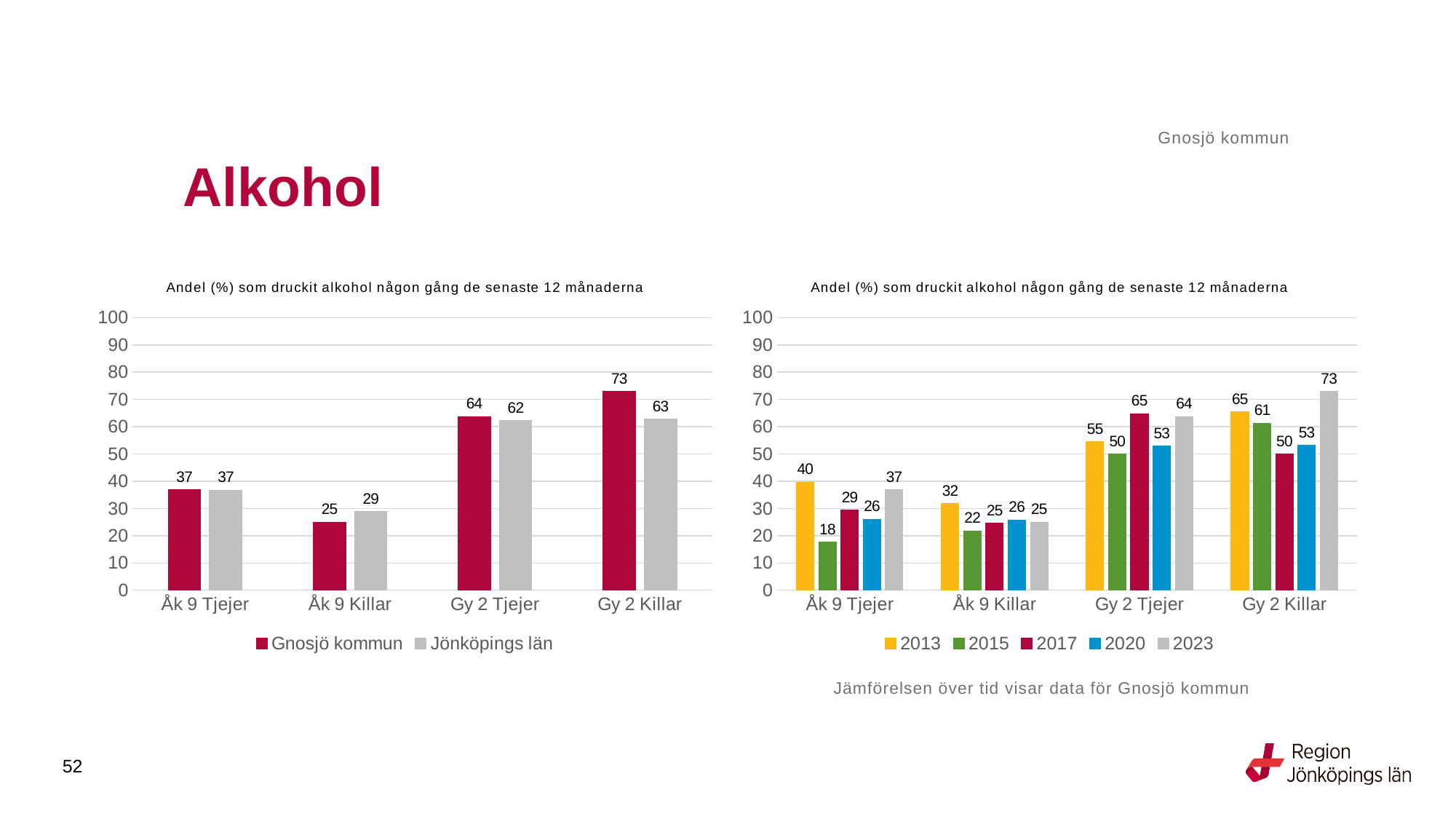
In the left chart, what is the value for Gnosjö kommun for Gy 2 Killar? 73 In the left chart, what is the value for Jönköpings län for Åk 9 Killar? 29 In the left chart, which category has the lowest value for Gnosjö kommun? Åk 9 Killar In the right chart, what is the value for 2023 for Gy 2 Killar? 73 In the left chart, what is the difference between Gnosjö kommun and Jönköpings län for Gy 2 Killar? 10 In the right chart, how many series does the legend list? 5 In the right chart, what is the value for 2015 for Åk 9 Tjejer? 18 What kind of chart is the right chart? Bar chart In the right chart, what is the difference between the 2013 and 2015 values for Åk 9 Tjejer? 22 In the right chart, which year has the highest value for Gy 2 Tjejer? 2017 In the right chart, which is larger for Åk 9 Killar: the value for 2013 or the value for 2023? 2013 In the left chart, how many series does the legend list? 2